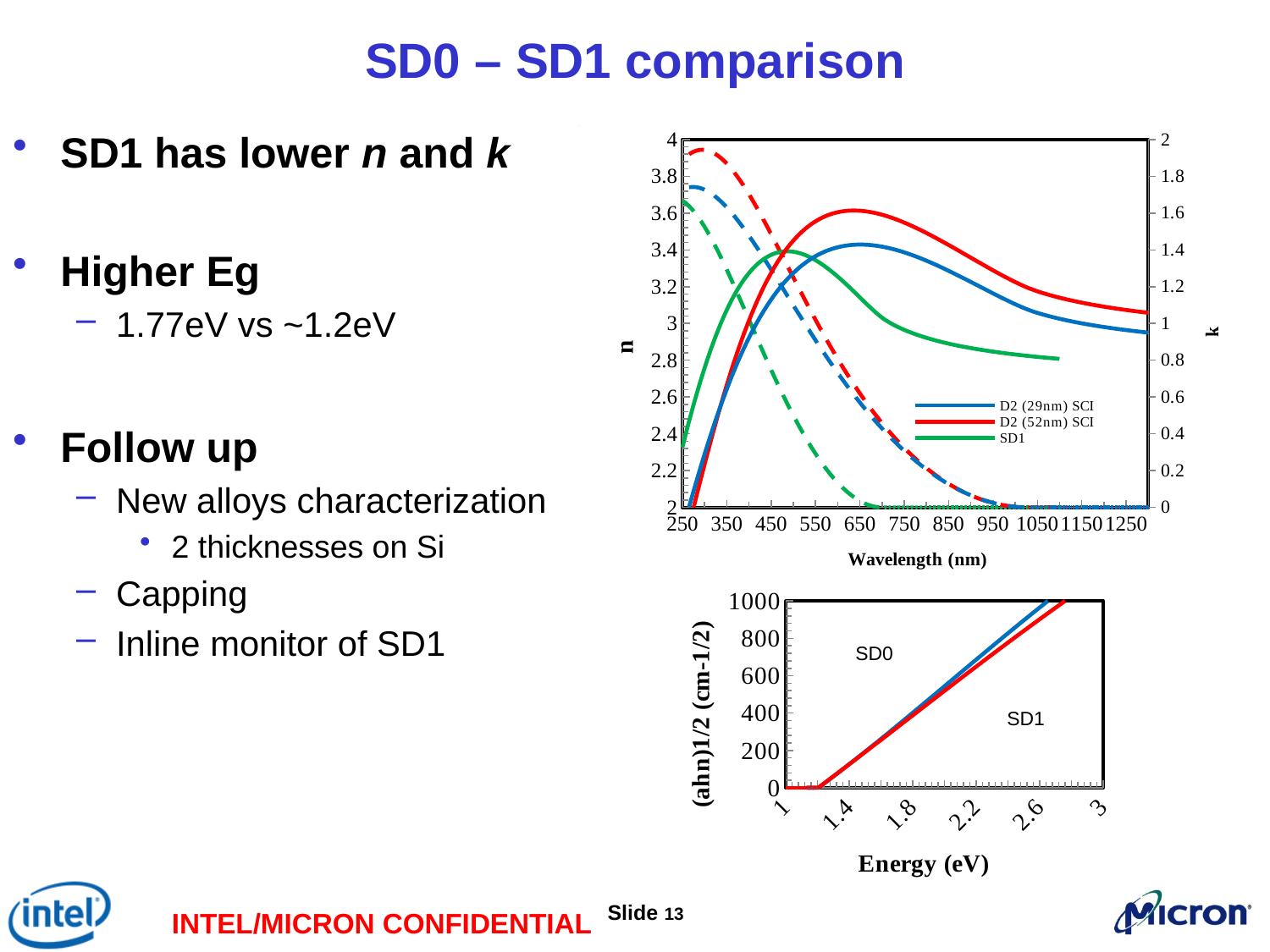
In the bottom chart, is the SD0 value at 2.2 eV greater or less than 400? greater What kind of chart is the bottom chart on the slide (Energy (eV) on the x axis)? line chart In the top chart, is the peak n value for D2 (52nm) SCI greater or less than 3.4? greater What is the x-axis title of the bottom chart? Energy (eV) In the top chart, which series has the lowest n value at 1050 nm? SD1 How many curves are plotted in the bottom chart? 2 In the top chart, is the n value for SD1 at 1050 nm greater or less than 3? less In the top chart, which series reaches the highest peak n value? D2 (52nm) SCI What kind of chart is the top chart on the slide (n and k versus wavelength)? line chart How many series does the legend of the top chart list? 3 What is the x-axis title of the top chart? Wavelength (nm) In the top chart, do the dashed k curves rise or fall as wavelength increases from 450 nm to 950 nm? fall